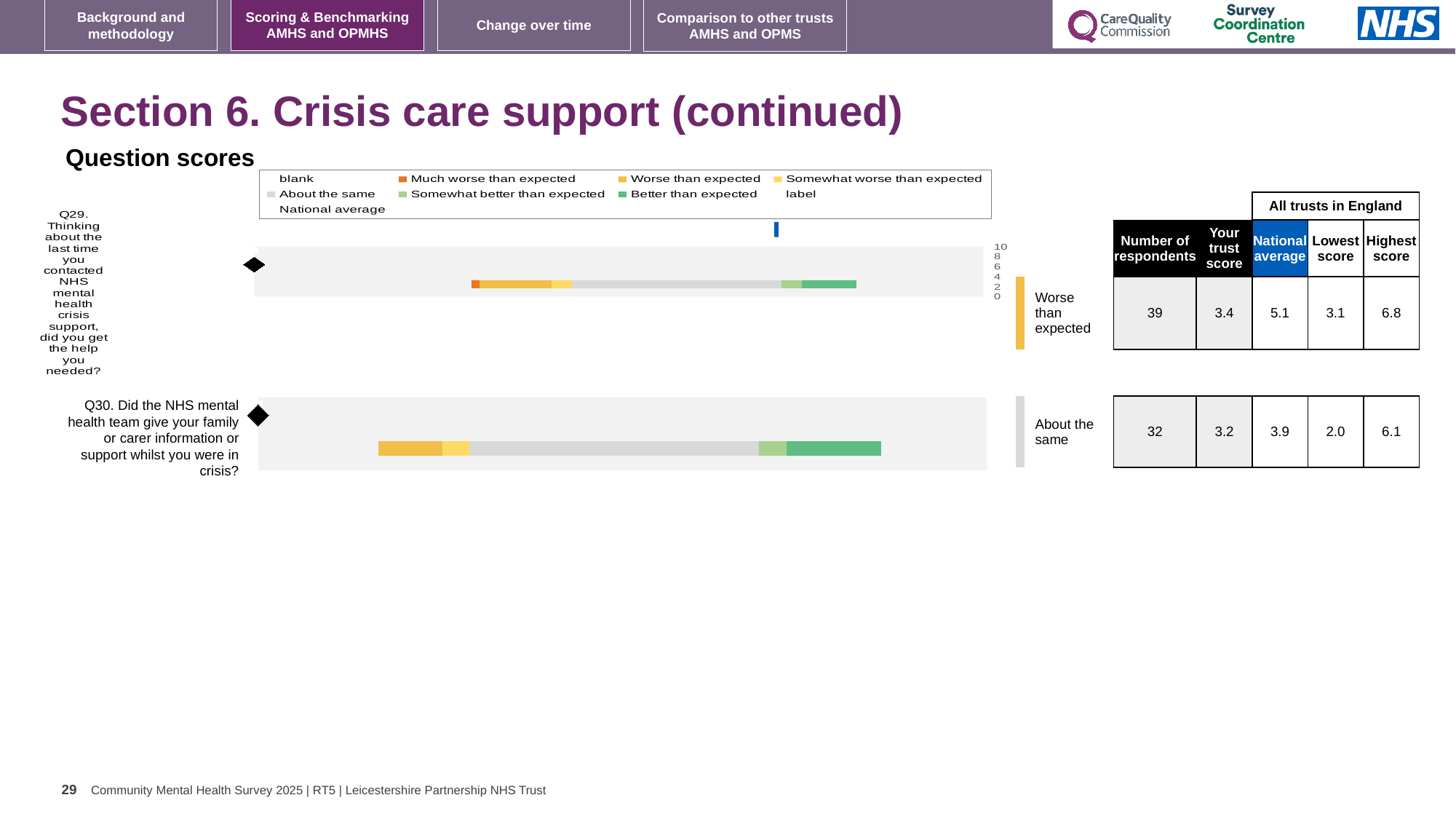
Which question had more respondents, Q29 or Q30? Q29 What rating label is shown next to the Q29 bar? Worse than expected What is the lowest score among all trusts in England for Q30? 2.0 What is the trust score for Q30 (did the NHS mental health team give your family or carer information or support)? 3.2 What is the national average score for Q29? 5.1 Which is larger for Q29, the trust score or the national average? the national average What is the trust score for Q29 (did you get the help you needed from NHS mental health crisis support)? 3.4 What kind of chart is used to show the question scores for Q29 and Q30? bar chart How many respondents answered Q29? 39 What is the highest score among all trusts in England for Q30? 6.1 What is the difference between the highest score and the lowest score for Q29? 3.7 How many questions are plotted in the question scores chart? 2